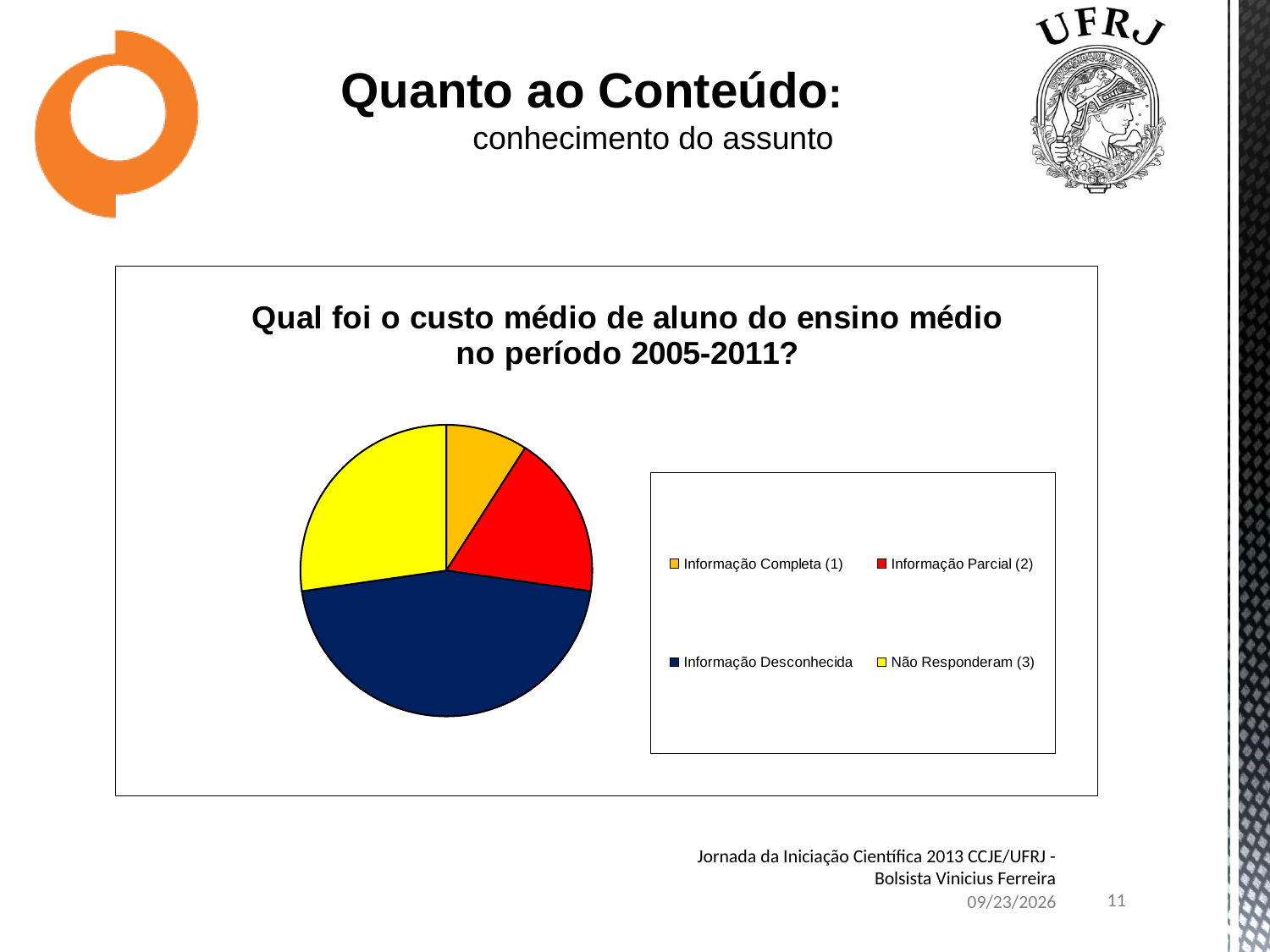
What is the title of the pie chart? Qual foi o custo médio de aluno do ensino médio no período 2005-2011? Which slice is larger: Não Responderam (3) or Informação Parcial (2)? Não Responderam (3) How many entries does the legend of the pie chart list? 4 Which slice is larger: Informação Desconhecida or Não Responderam (3)? Informação Desconhecida Which category has the smallest slice of the pie chart? Informação Completa (1) Which slice is larger: Informação Parcial (2) or Informação Completa (1)? Informação Parcial (2) What colour represents Informação Desconhecida in the pie chart? dark blue Which category has the largest slice of the pie chart? Informação Desconhecida What kind of chart is shown on the slide? pie chart How many slices does the pie chart have? 4